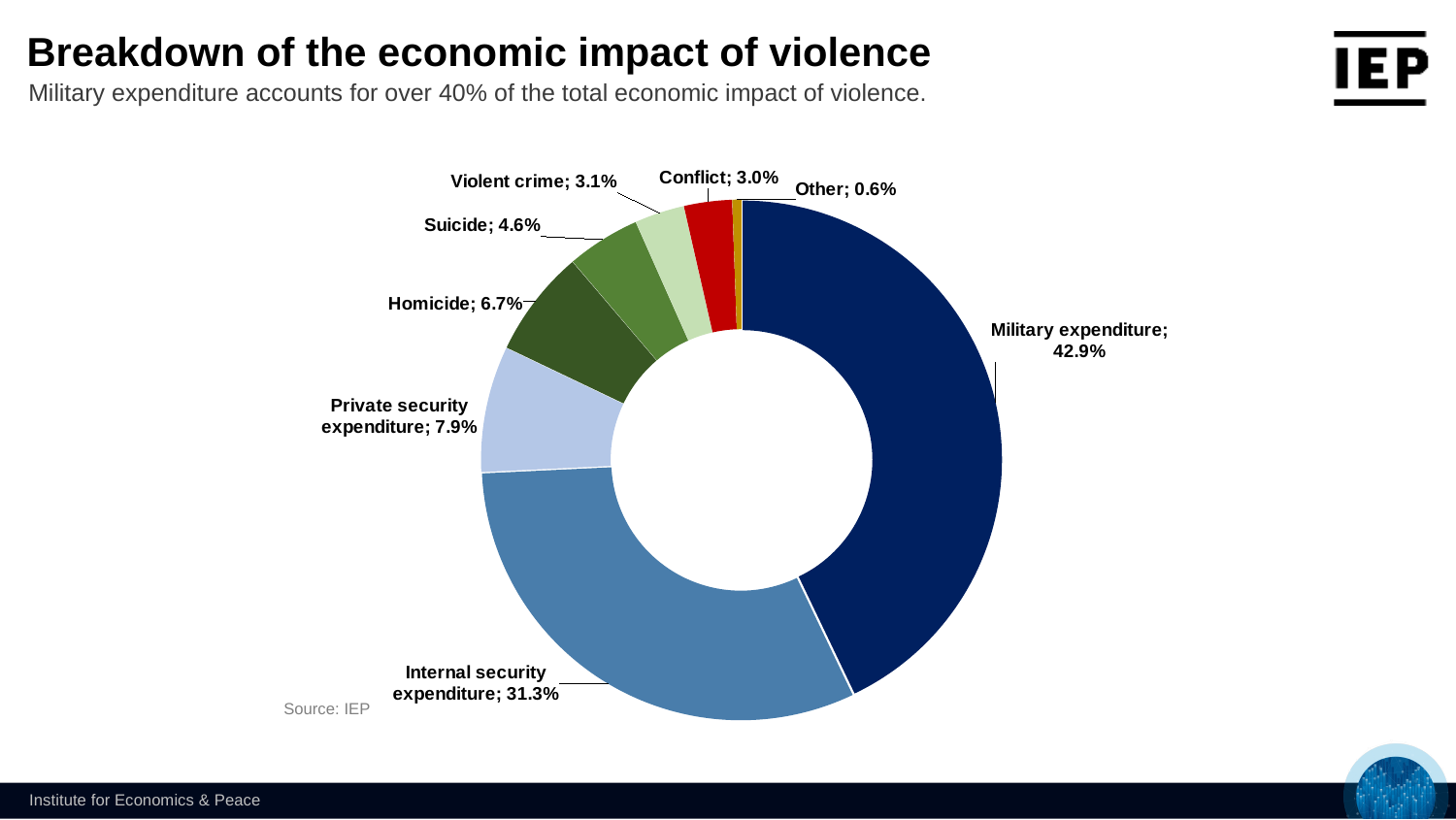
What percentage does Internal security expenditure account for? 31.3% What type of chart is shown on the slide? Pie chart (doughnut) What is the share for Suicide? 4.6% What is the difference in percentage points between Military expenditure and Internal security expenditure? 11.6 How many categories are shown in the chart? 8 Which category has the smallest share? Other What is the title of the slide? Breakdown of the economic impact of violence Which category has the largest share of the economic impact of violence? Military expenditure What share of the economic impact of violence is attributed to Military expenditure? 42.9% What is the share for Private security expenditure? 7.9% Which has a larger share, Violent crime or Conflict? Violent crime What percentage is shown for Homicide? 6.7%